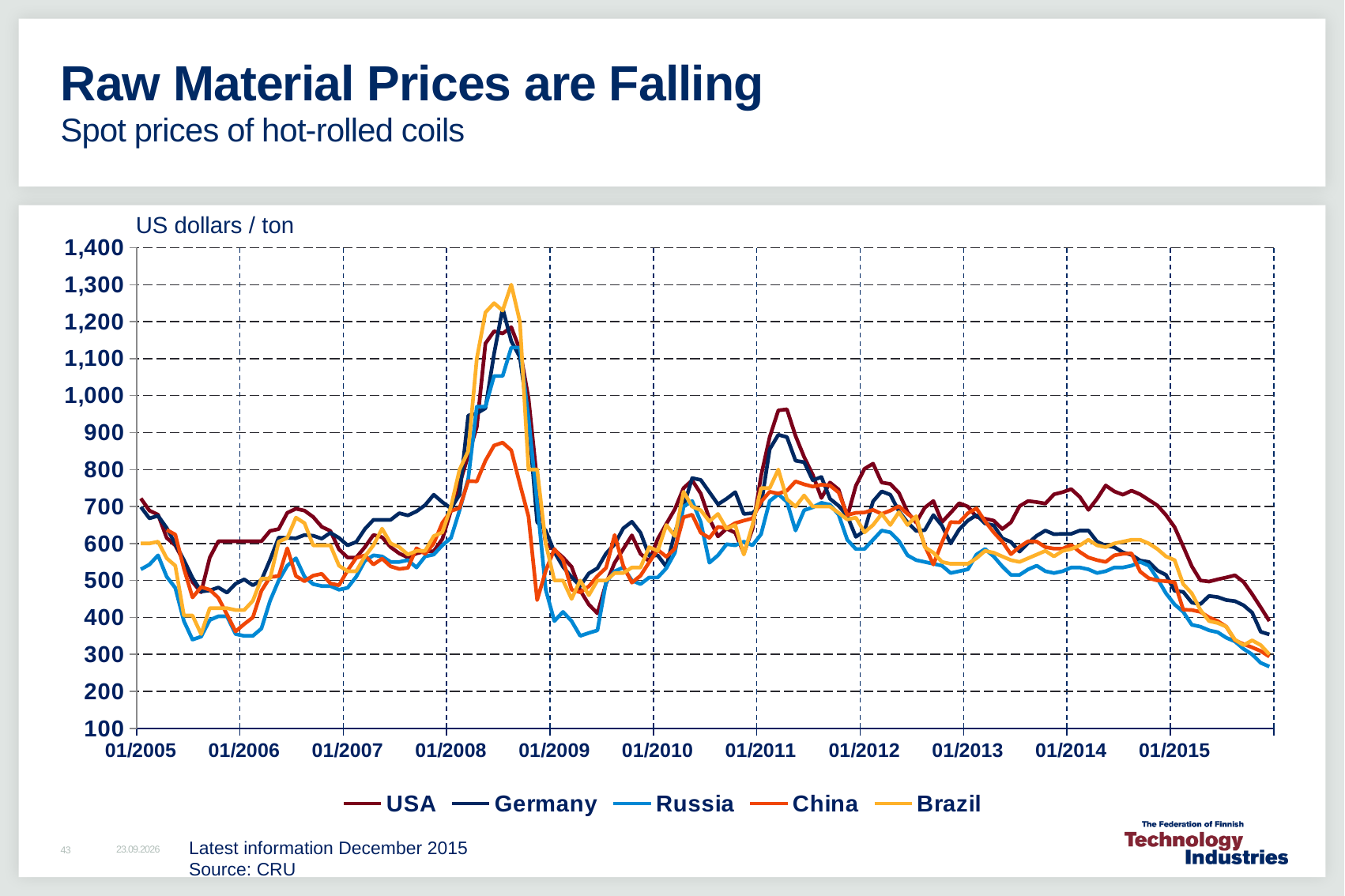
Is the value for Russia at the end of 2015 greater or less than 300? less How many series does the legend list? 5 Which series had the lowest peak during the 2008 price spike? China Is the peak value for China in 2008 greater or less than 1,000? less Which series reached the highest value anywhere on the chart? Brazil Is the peak value for Brazil in 2008 greater or less than 1,200? greater How many year labels are shown on the horizontal axis? 11 At 01/2015, which is higher, the USA price or the Russia price? USA What unit is shown on the vertical axis of the chart? US dollars / ton What kind of chart is shown on the slide? line chart What is the subtitle of the chart slide? Spot prices of hot-rolled coils Does the USA price rise or fall between 01/2014 and the end of 2015? fall